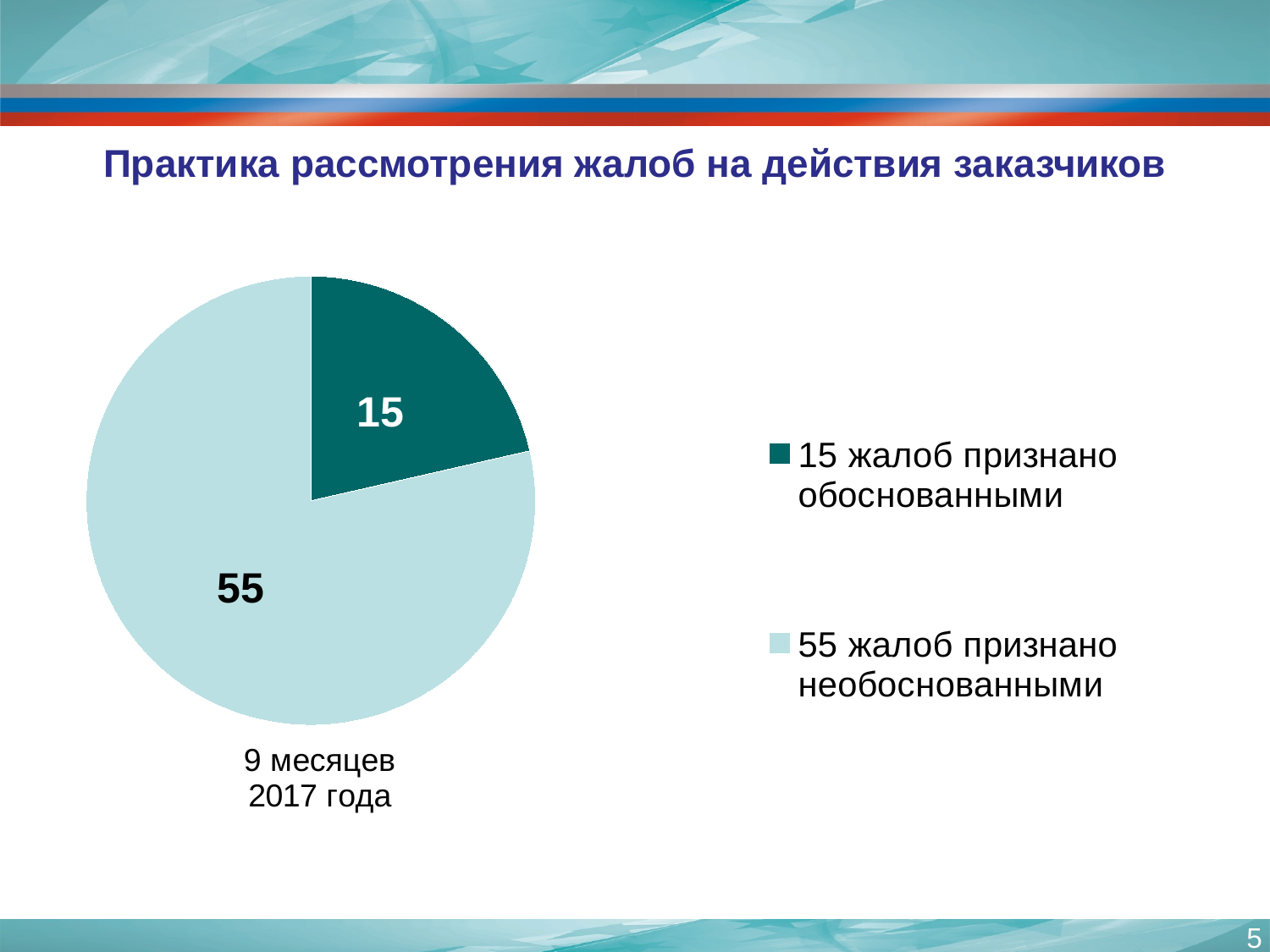
What colour is the slice representing the 15 complaints recognised as founded? Dark teal What value is shown for the slice labelled "55 жалоб признано необоснованными"? 55 Which is larger: the number of complaints recognised as founded or the number recognised as unfounded? Recognised as unfounded (55) Which slice of the pie chart is the smallest? 15 жалоб признано обоснованными Which slice of the pie chart is the largest? 55 жалоб признано необоснованными How many slices does the pie chart have? 2 What value is shown for the slice labelled "15 жалоб признано обоснованными"? 15 What is the total number of complaints represented in the pie chart? 70 What is the difference between the number of complaints recognised as unfounded (55) and those recognised as founded (15)? 40 How many entries does the legend of the pie chart list? 2 What kind of chart is shown on the slide? Pie chart What period does the caption under the pie chart refer to? 9 месяцев 2017 года